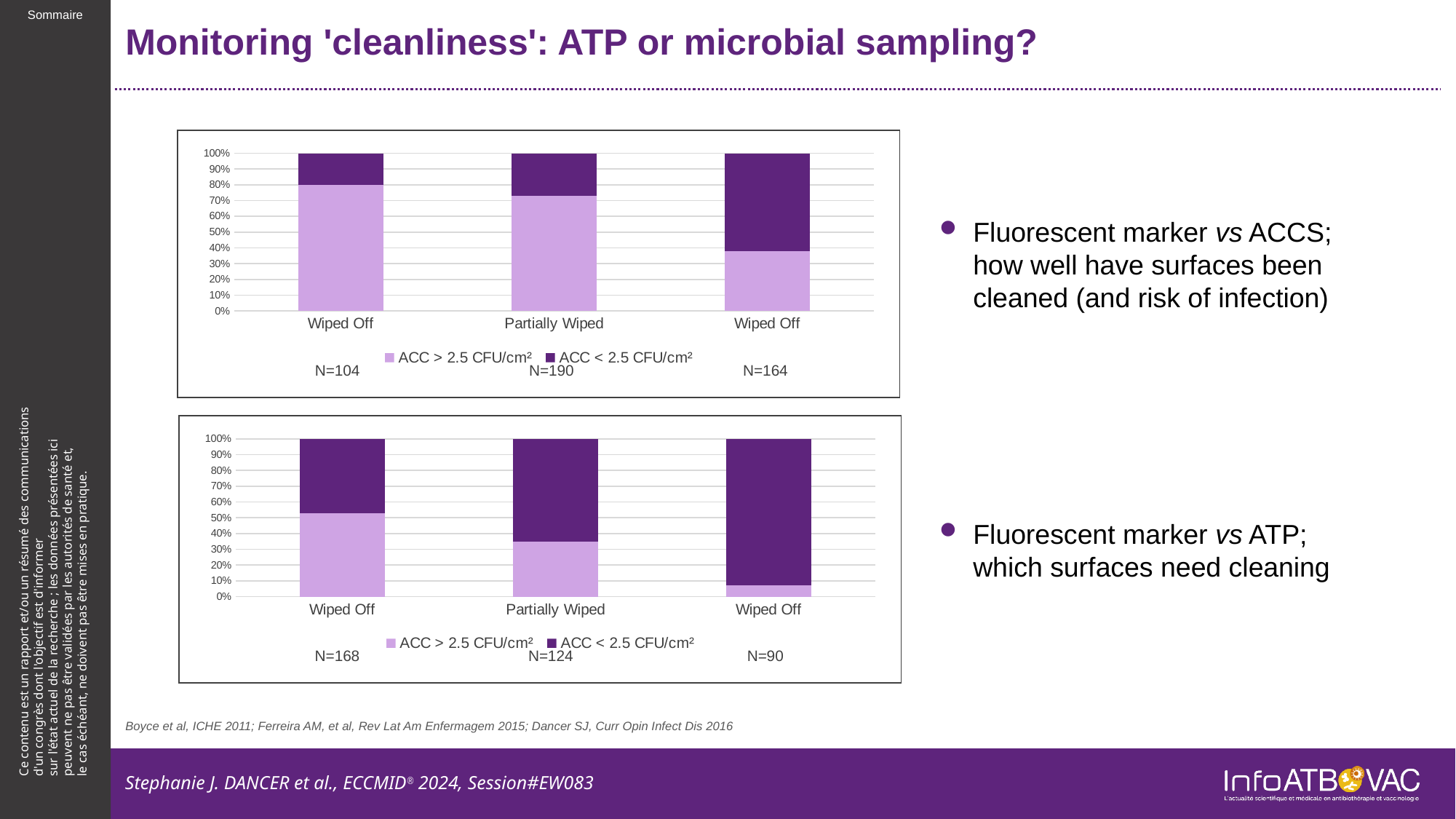
In the top chart, is the ACC > 2.5 CFU/cm² share for the rightmost 'Wiped Off' bar greater or less than 50%? less In the top chart, is the ACC > 2.5 CFU/cm² share for the leftmost 'Wiped Off' bar greater or less than 70%? greater How many bars are plotted in the top chart? 3 In the bottom chart, does the ACC > 2.5 CFU/cm² share rise or fall from left to right across the bars? fall In the bottom chart, is the ACC > 2.5 CFU/cm² share for the rightmost 'Wiped Off' bar greater or less than 20%? less What kind of chart is the top chart on the slide? stacked bar chart In the top chart, which bar has the smallest ACC > 2.5 CFU/cm² share? the rightmost Wiped Off bar What N value is printed under the 'Partially Wiped' bar of the bottom chart? N=124 How many series does the legend of the bottom chart list? 2 In the top chart, is the ACC < 2.5 CFU/cm² share larger for 'Partially Wiped' or for the rightmost 'Wiped Off' bar? the rightmost Wiped Off bar In the bottom chart, which bar has the largest ACC > 2.5 CFU/cm² share? the leftmost Wiped Off bar